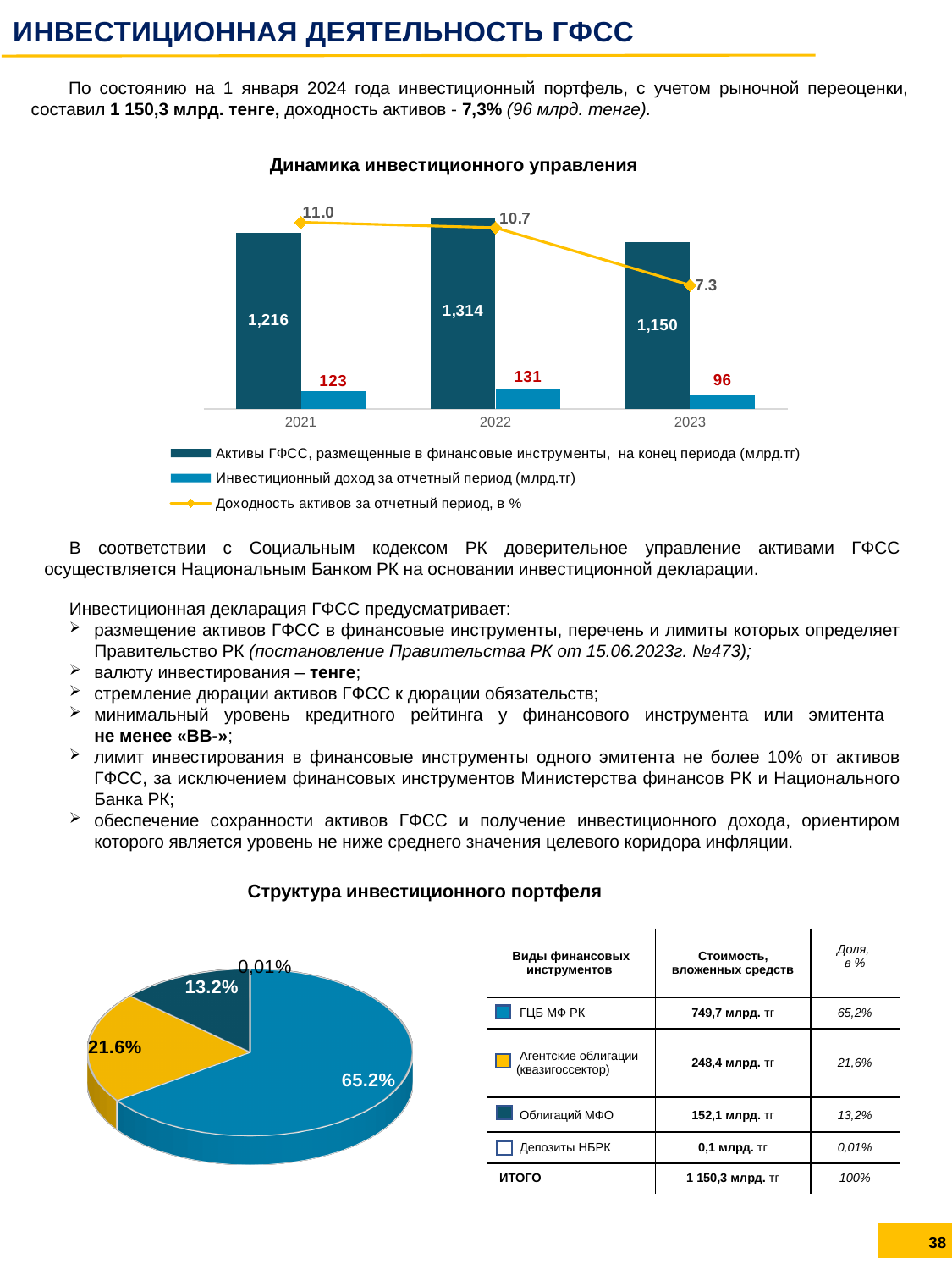
On the chart 'Динамика инвестиционного управления', what is the 'Инвестиционный доход за отчетный период' for 2023? 96 What type of chart is 'Структура инвестиционного портфеля'? pie chart On the chart 'Динамика инвестиционного управления', what is the 'Доходность активов за отчетный период, в %' for 2021? 11.0 On the pie chart 'Структура инвестиционного портфеля', what is the share of the largest slice? 65.2% On the chart 'Динамика инвестиционного управления', which year has the highest value for 'Активы ГФСС, размещенные в финансовые инструменты'? 2022 On the chart 'Динамика инвестиционного управления', does the 'Доходность активов' line rise or fall from 2021 to 2023? fall On the chart 'Динамика инвестиционного управления', how many series does the legend list? 3 On the pie chart 'Структура инвестиционного портфеля', how many slices are labelled? 4 On the chart 'Динамика инвестиционного управления', which year has the lowest 'Инвестиционный доход за отчетный период'? 2023 On the chart 'Динамика инвестиционного управления', how many years are shown on the x axis? 3 On the chart 'Динамика инвестиционного управления', what is the value of 'Активы ГФСС, размещенные в финансовые инструменты' for 2022? 1,314 On the chart 'Динамика инвестиционного управления', what is the difference between the 'Инвестиционный доход' for 2022 and 2021? 8